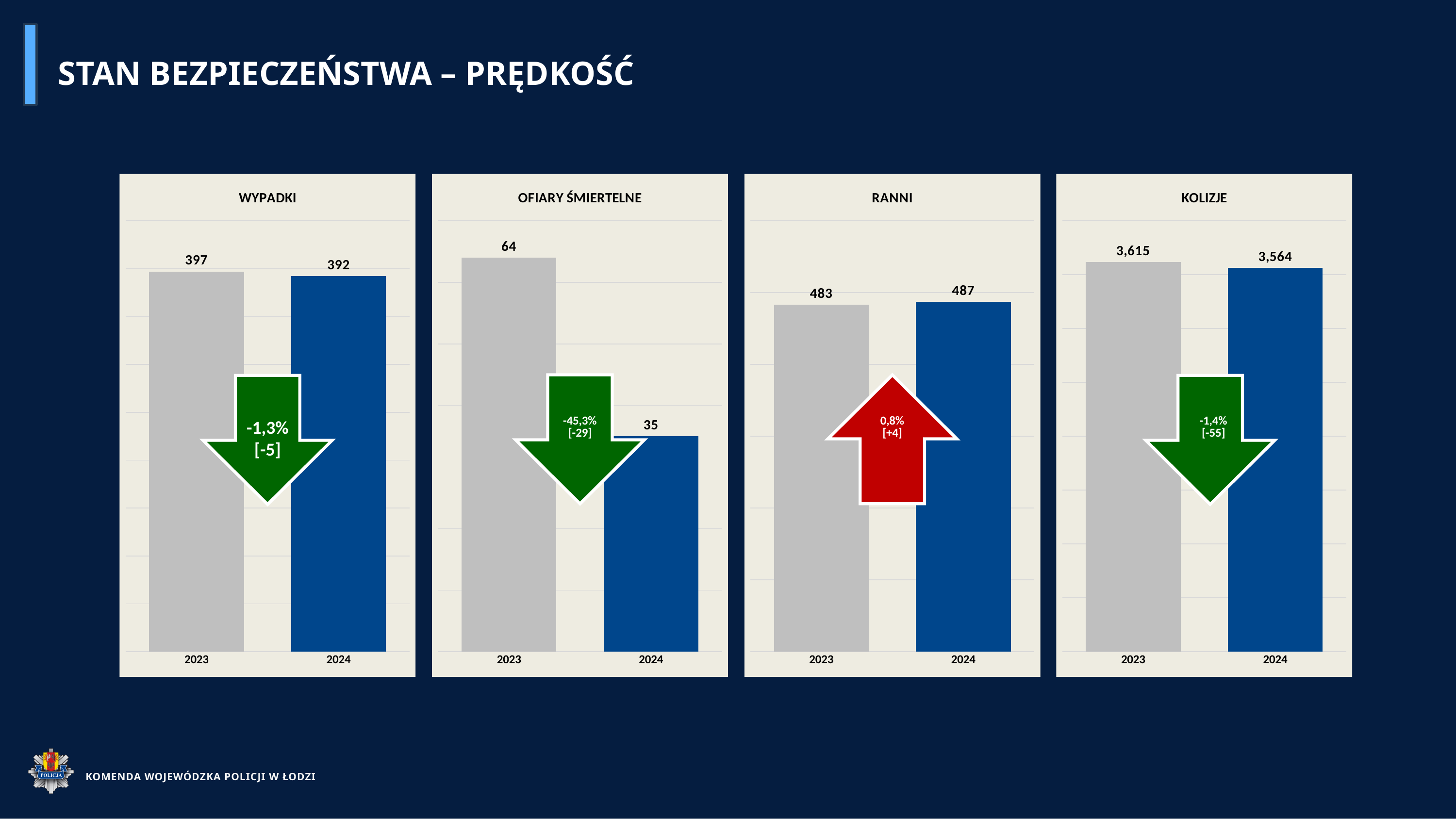
In the WYPADKI chart, what is the value for 2023? 397 In the WYPADKI chart, what is the value for 2024? 392 In the OFIARY ŚMIERTELNE chart, what is the value for 2024? 35 How many categories are shown on the x axis of the KOLIZJE chart? 2 What kind of chart is the WYPADKI chart? Bar chart In the RANNI chart, what is the value for 2023? 483 In the OFIARY ŚMIERTELNE chart, what is the difference between the 2023 and 2024 values? 29 In the KOLIZJE chart, what is the difference between the 2023 and 2024 values? 55 In the RANNI chart, what percentage change is shown on the arrow? 0,8% In the RANNI chart, which year has the higher value, 2023 or 2024? 2024 In the KOLIZJE chart, what is the value for 2023? 3,615 In the OFIARY ŚMIERTELNE chart, which year has the lowest value? 2024